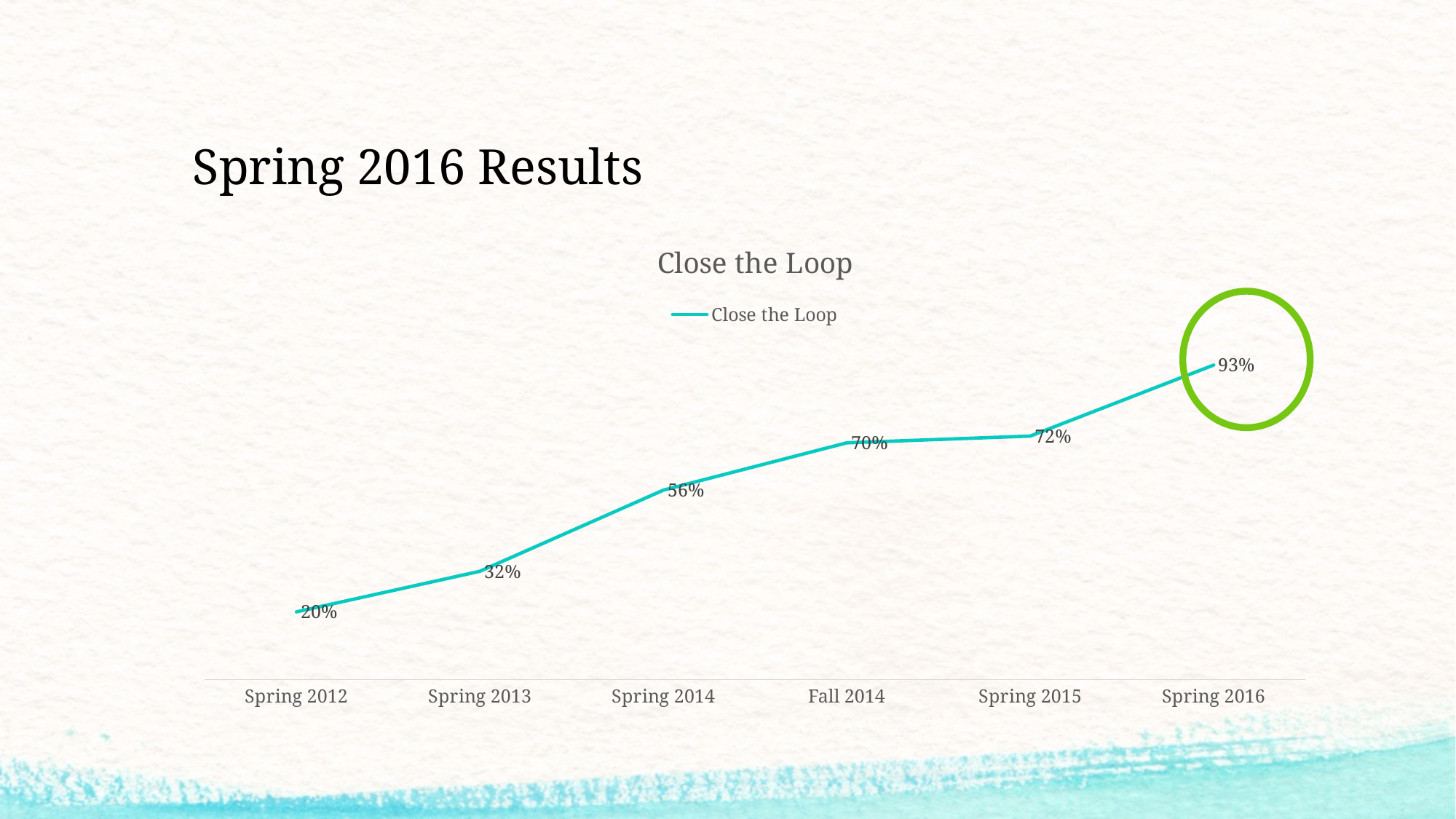
What is the value for Spring 2016 in the Close the Loop chart? 93% Do the values rise or fall from Spring 2012 to Spring 2016? Rise Which period has the highest value? Spring 2016 Which is larger, the value for Spring 2014 or the value for Spring 2013? Spring 2014 What is the value for Fall 2014? 70% Which period has the lowest value? Spring 2012 What is the value for Spring 2012? 20% What is the difference between the Spring 2013 and Spring 2012 values? 12% What is the difference between the Spring 2016 and Spring 2015 values? 21% How many data points are plotted on the line? 6 What is the value for Spring 2014? 56% What kind of chart is shown? Line chart